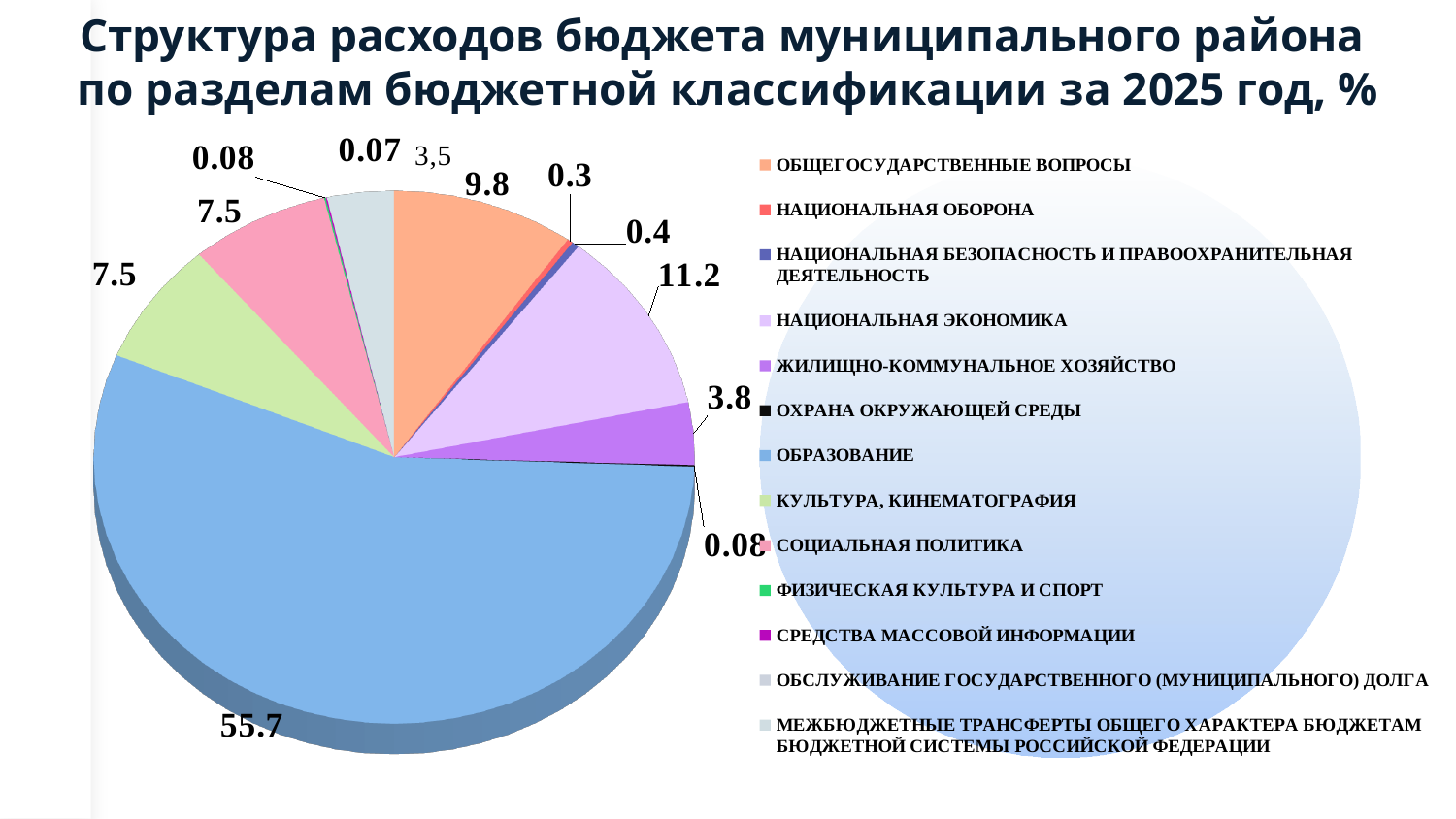
How many categories does the legend list? 13 Which is larger, the value for НАЦИОНАЛЬНАЯ ЭКОНОМИКА or the value for ОБЩЕГОСУДАРСТВЕННЫЕ ВОПРОСЫ? НАЦИОНАЛЬНАЯ ЭКОНОМИКА What is the value for НАЦИОНАЛЬНАЯ ОБОРОНА? 0.3 Which category has the largest share of the pie? ОБРАЗОВАНИЕ What is the value for ЖИЛИЩНО-КОММУНАЛЬНОЕ ХОЗЯЙСТВО? 3.8 What is the value for НАЦИОНАЛЬНАЯ ЭКОНОМИКА? 11.2 What is the difference between the values for НАЦИОНАЛЬНАЯ ЭКОНОМИКА and ОБЩЕГОСУДАРСТВЕННЫЕ ВОПРОСЫ? 1.4 What year does the chart title refer to? 2025 What is the value for ОБРАЗОВАНИЕ? 55.7 What is the value for ОБЩЕГОСУДАРСТВЕННЫЕ ВОПРОСЫ? 9.8 What kind of chart is shown on the slide? pie chart What is the difference between the values for ОБРАЗОВАНИЕ and НАЦИОНАЛЬНАЯ ЭКОНОМИКА? 44.5